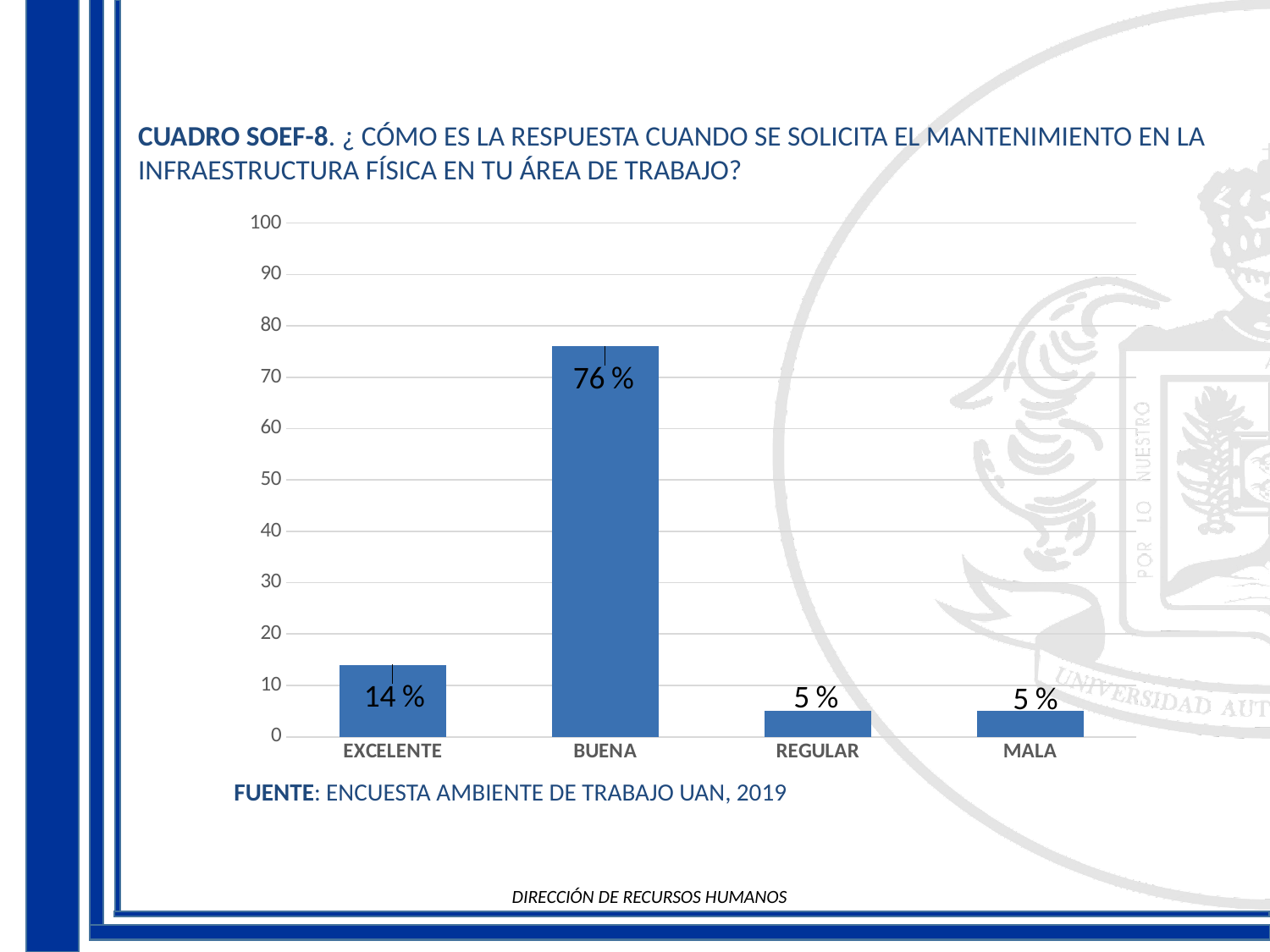
What kind of chart is shown on the slide? bar chart What is the source cited below the chart? ENCUESTA AMBIENTE DE TRABAJO UAN, 2019 How many categories are shown on the x axis? 4 What is the value for BUENA? 76 % What is the highest value shown on the vertical axis? 100 Is the value for BUENA greater or less than 70? greater Which is larger, the value for EXCELENTE or the value for MALA? EXCELENTE What is the difference between the values for BUENA and EXCELENTE? 62 % Is the value for REGULAR greater or less than 10? less What is the value for REGULAR? 5 % What is the value for EXCELENTE? 14 % Which category has the highest value? BUENA